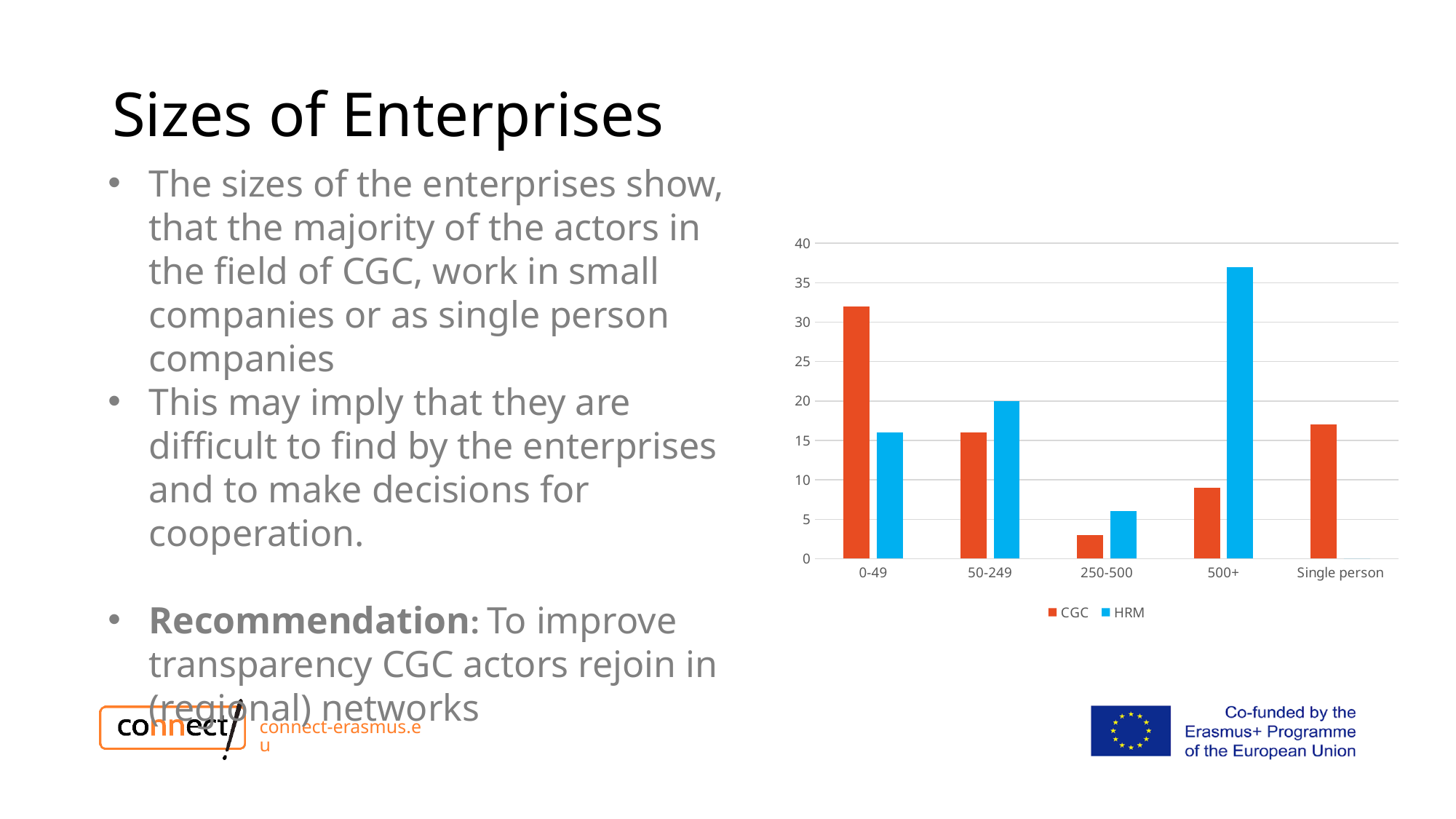
Which category has the highest HRM value? 500+ How many series does the chart legend list? 2 Is the HRM value for 500+ greater or less than 35? greater Which category has the lowest CGC value? 250-500 For the 0-49 category, which series has the larger value, CGC or HRM? CGC Is the CGC value for 0-49 greater or less than 30? greater Which category has the highest CGC value? 0-49 Is the CGC value for 250-500 greater or less than 5? less What kind of chart is shown on the slide? bar chart How many enterprise size categories are shown on the x axis? 5 For the 500+ category, which series has the larger value, CGC or HRM? HRM Which series is shown in blue in the chart? HRM